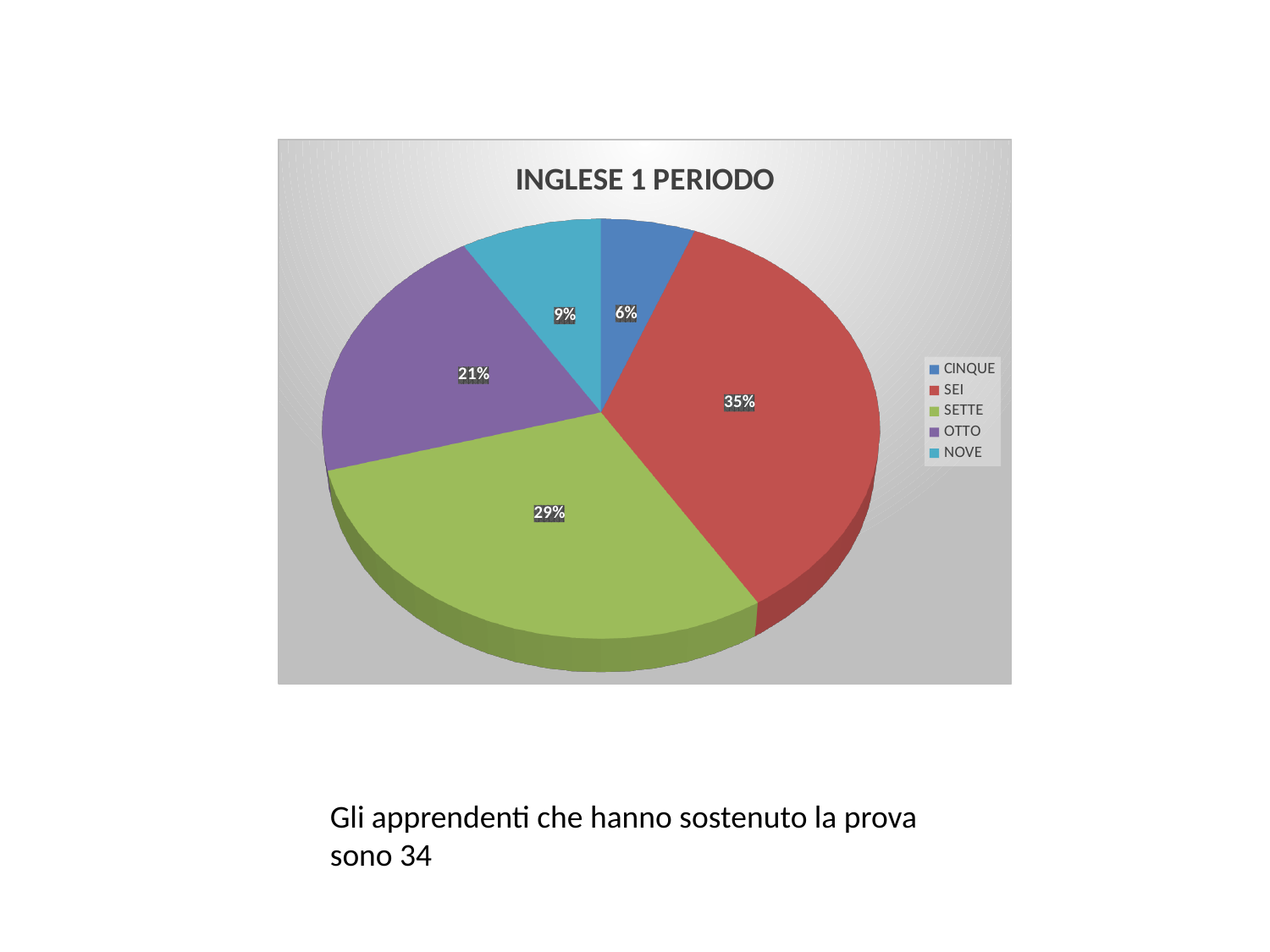
What kind of chart is shown on the slide? pie chart Which slice is larger, OTTO or NOVE? OTTO What percentage of the pie does the SEI slice represent? 35% How many categories does the legend list? 5 Which category has the smallest slice of the pie? CINQUE What percentage of the pie does the OTTO slice represent? 21% Which category has the largest slice of the pie? SEI What percentage of the pie does the NOVE slice represent? 9% What is the title of the chart? INGLESE 1 PERIODO What is the difference in percentage points between the SEI slice and the SETTE slice? 6